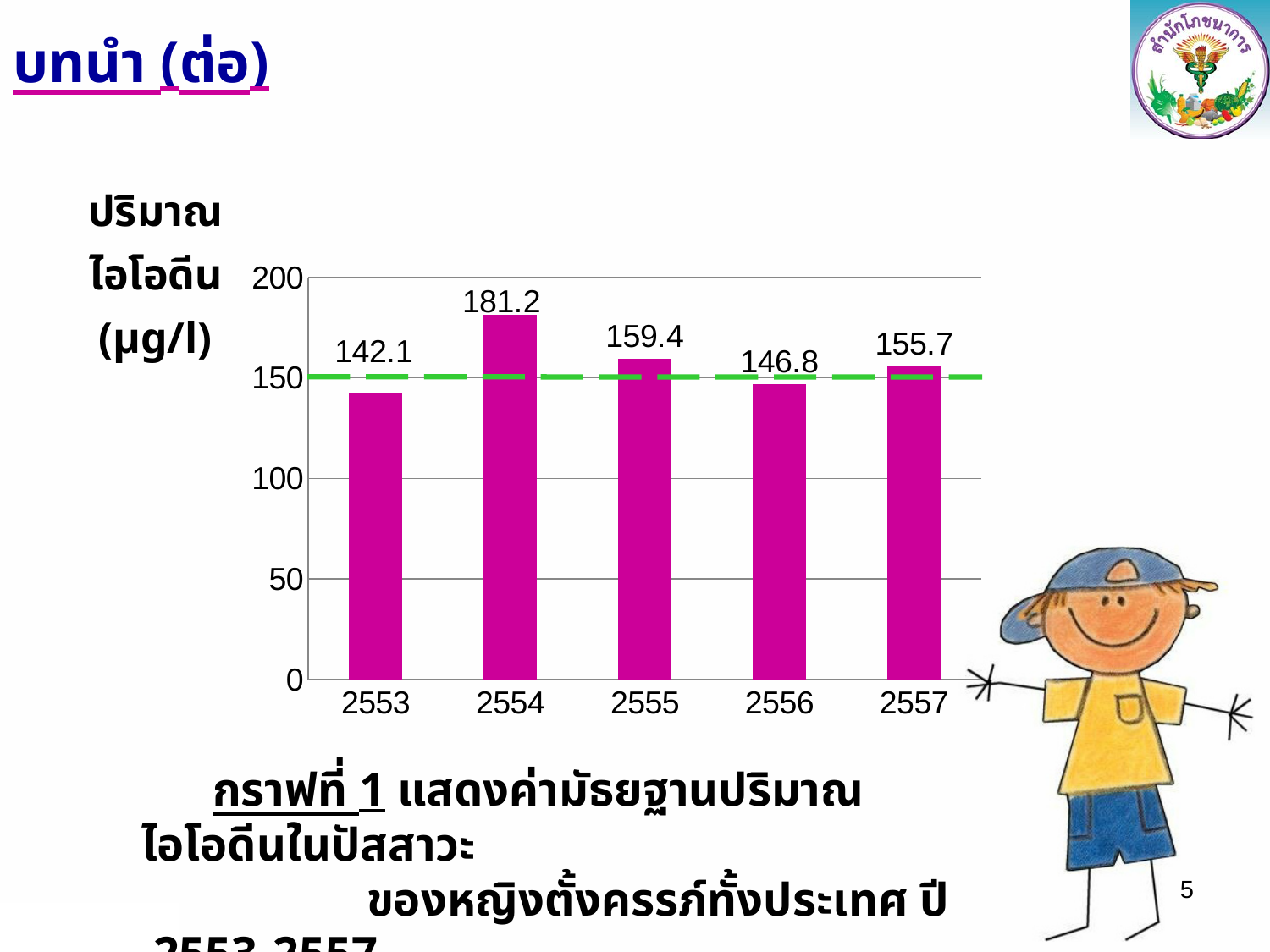
What kind of chart is shown on the slide? bar chart What is the difference between the values for 2554 and 2553? 39.1 What is the unit shown in the y-axis label? µg/l What is the value for 2557? 155.7 What is the difference between the values for 2555 and 2556? 12.6 What is the value for 2553? 142.1 Which year has the highest value? 2554 Is the value for 2556 greater or less than 150? less How many years are shown on the x axis? 5 Which year has the lowest value? 2553 What is the value for 2554? 181.2 Which is larger, the value for 2555 or the value for 2557? 2555